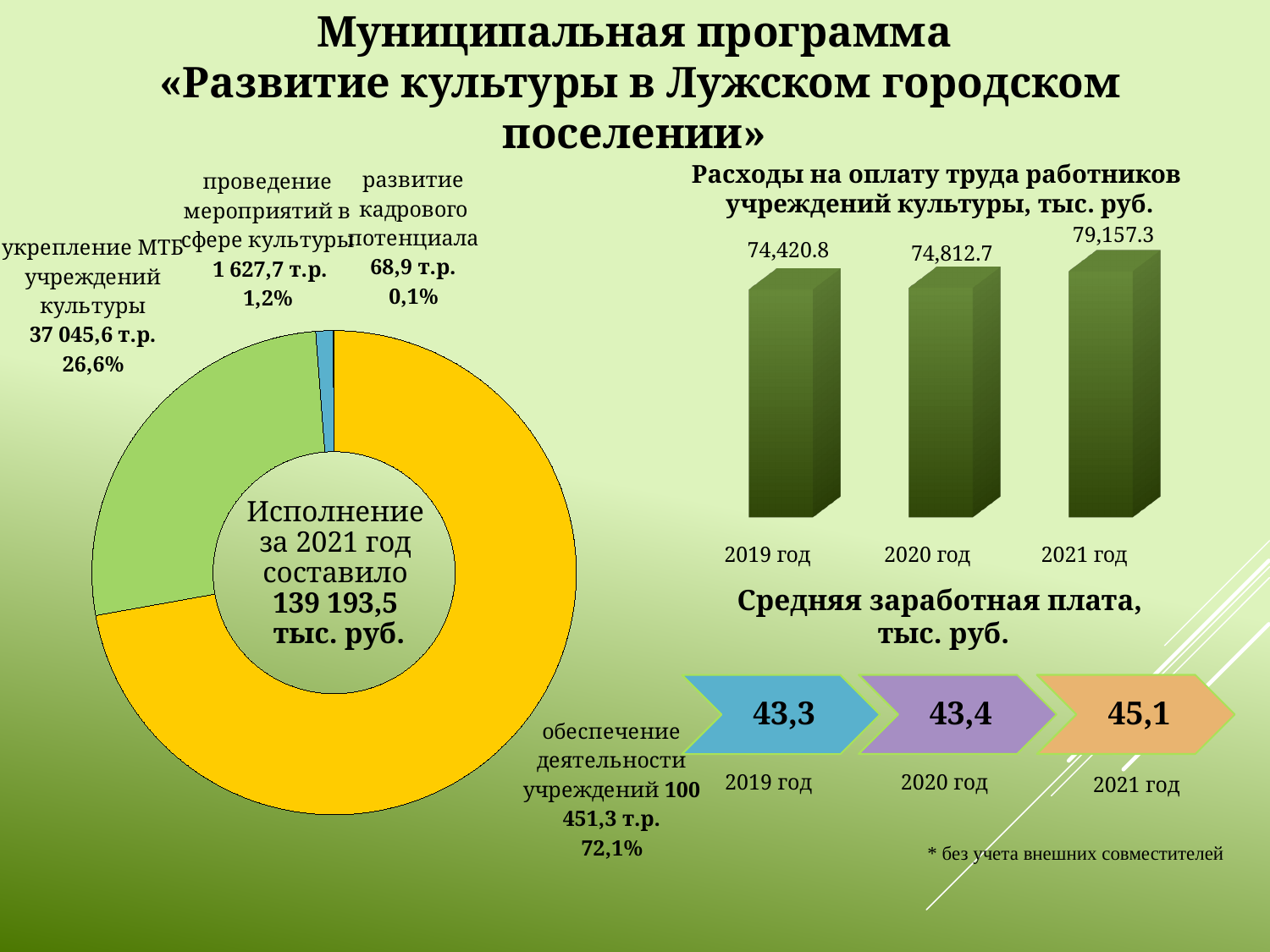
In the chart «Расходы на оплату труда работников учреждений культуры, тыс. руб.», which year has the highest value? 2021 год In the chart «Расходы на оплату труда работников учреждений культуры, тыс. руб.», what is the difference between 2021 год and 2019 год? 4,736.5 In the chart «Расходы на оплату труда работников учреждений культуры, тыс. руб.», what is the value for 2021 год? 79,157.3 In the donut chart on the left, which category has the largest share? обеспечение деятельности учреждений In the donut chart on the left, what total is shown in the centre for 2021? 139 193,5 тыс. руб. What type of chart is the chart on the left side of the slide? pie chart (donut) In the donut chart on the left, which category has the smallest share? развитие кадрового потенциала In the donut chart on the left, what share does «обеспечение деятельности учреждений» have? 72,1% In the chart «Расходы на оплату труда работников учреждений культуры, тыс. руб.», what is the value for 2019 год? 74,420.8 How many segments does the donut chart on the left have? 4 In the chart «Расходы на оплату труда работников учреждений культуры, тыс. руб.», do the values rise or fall from 2019 to 2021? rise In the donut chart on the left, what is the value for «укрепление МТБ учреждений культуры»? 37 045,6 т.р.